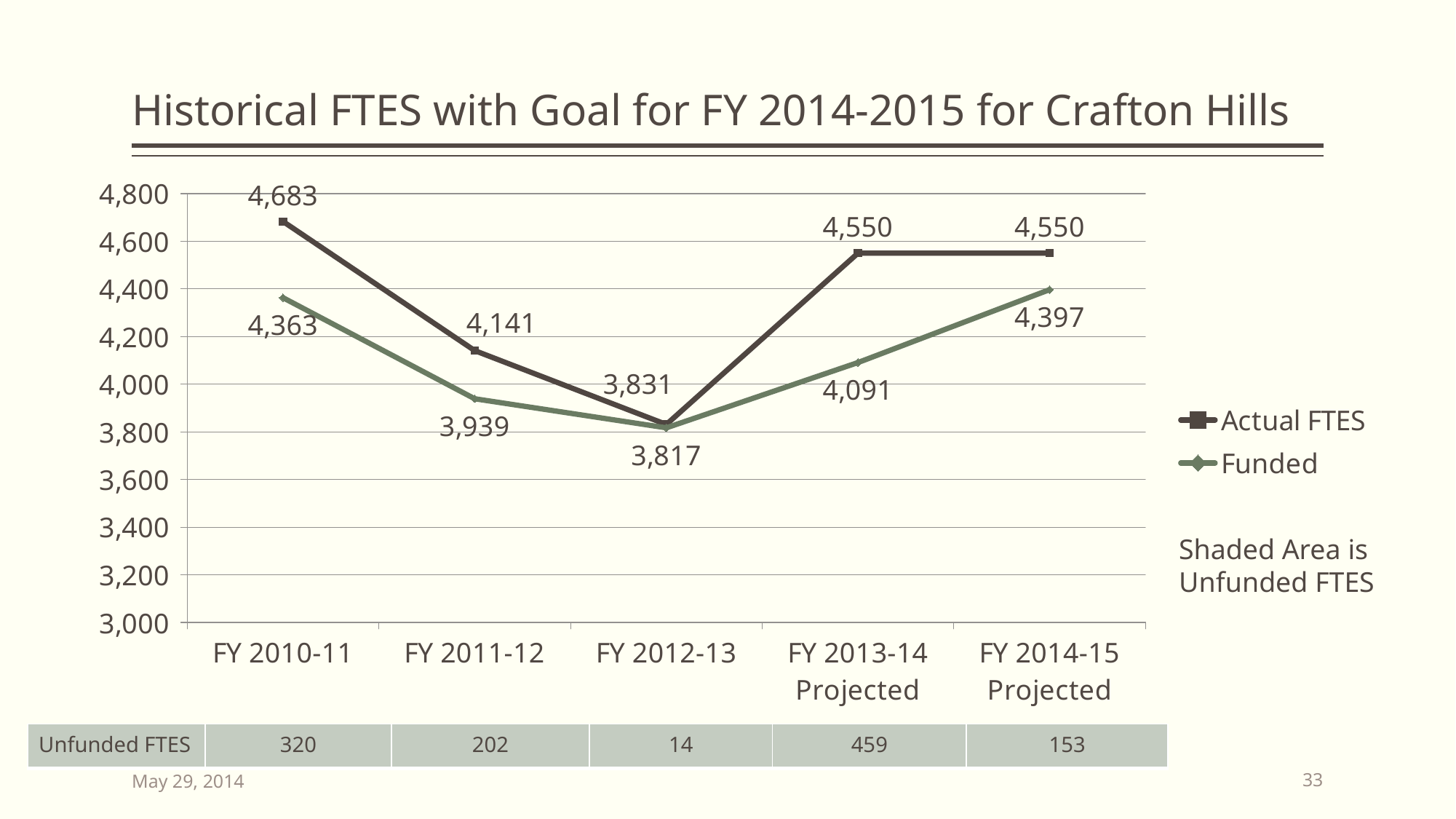
What is the difference between Actual FTES and Funded for FY 2013-14 Projected? 459 What is the Actual FTES value for FY 2010-11? 4,683 Which fiscal year has the highest Actual FTES value? FY 2010-11 How many series does the legend list? 2 How many fiscal years are shown on the x axis? 5 What is the Funded value for FY 2014-15 Projected? 4,397 What kind of chart is shown on the slide? Line chart Does the Actual FTES series rise or fall from FY 2010-11 to FY 2012-13? Fall Which fiscal year has the lowest Funded value? FY 2012-13 What is the Funded value for FY 2012-13? 3,817 Which is larger for FY 2011-12: Actual FTES or Funded? Actual FTES What is the Unfunded FTES value shown in the table for FY 2010-11? 320